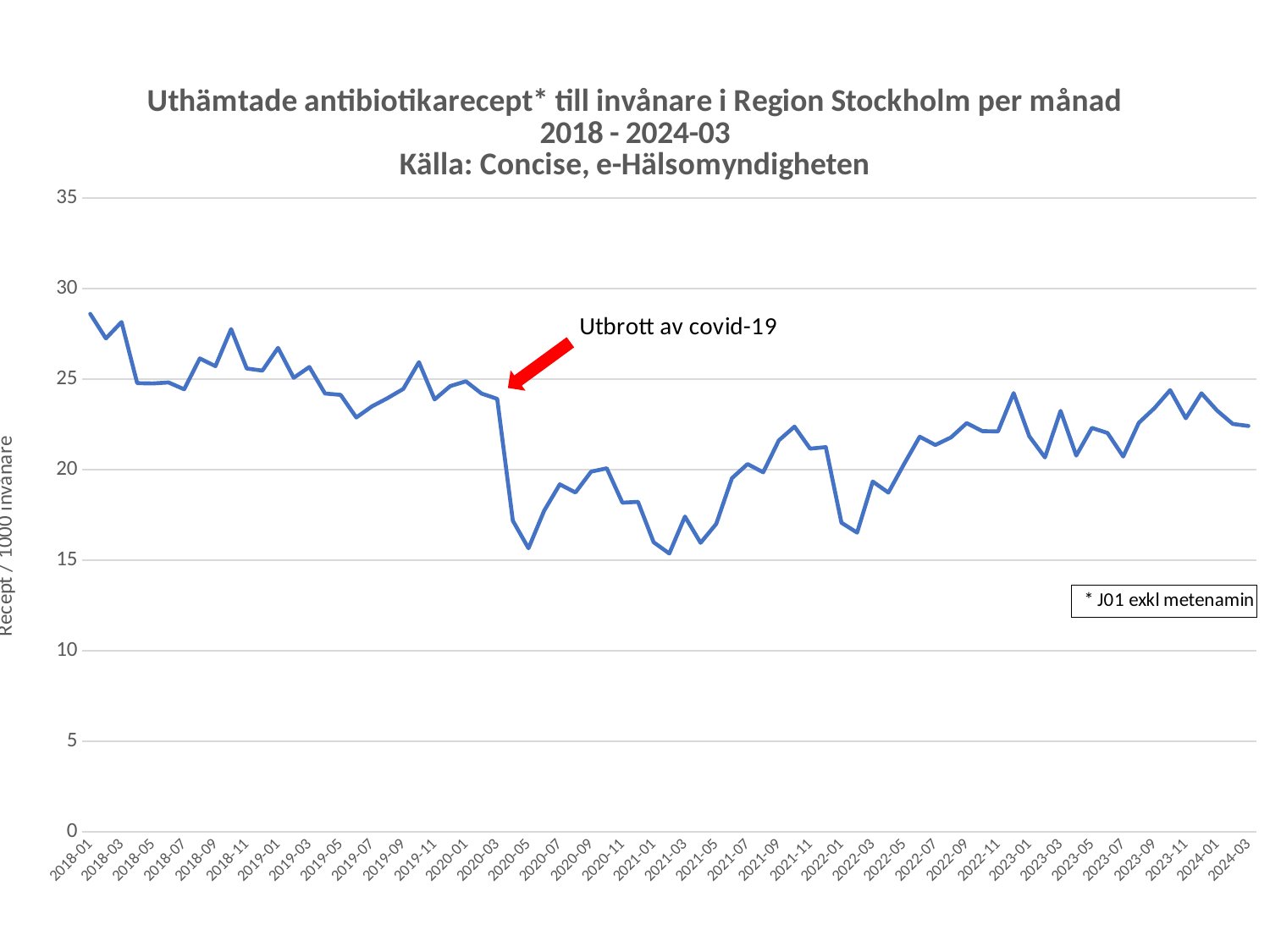
Is the value for 2020-05 greater or less than 20? less Is the value for 2023-01 greater or less than 20? greater Is the value for 2024-03 greater or less than 20? greater What is the label of the vertical axis? Recept / 1000 invånare What kind of chart is shown on the slide? line chart Does the line rise or fall between 2021-03 and 2021-11? rise What event does the red arrow annotation on the chart point to? Utbrott av covid-19 Does the line rise or fall between 2020-03 and 2020-05? fall